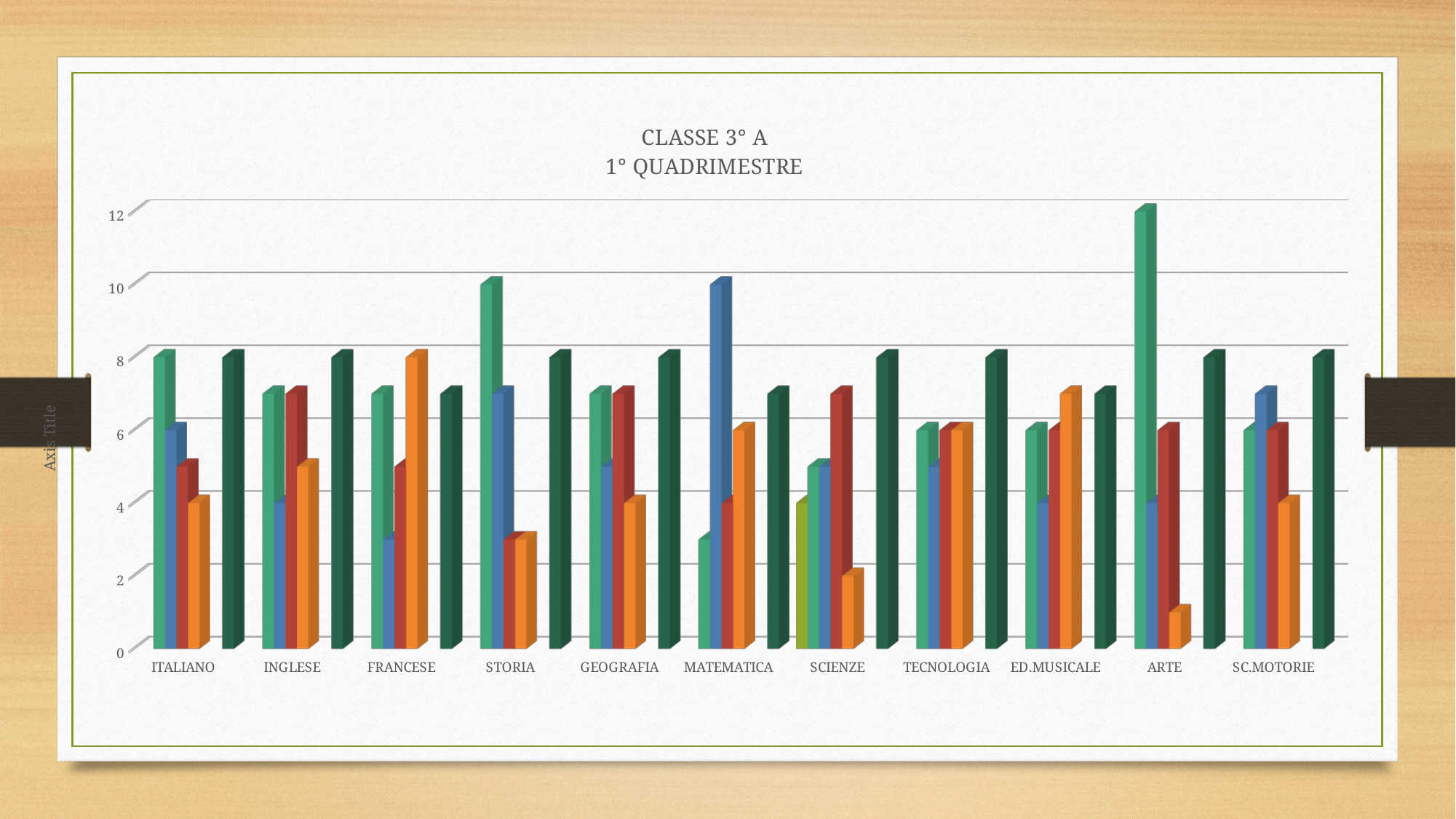
What kind of chart is shown on the slide? bar chart Which category contains the tallest bar in the chart? ARTE Is the orange bar for FRANCESE greater or less than 6? greater Is the tallest bar for ARTE greater or less than 10? greater For STORIA, which is taller: the first (green) bar or the orange bar? the green bar What text is shown as the vertical axis title? Axis Title Is the orange bar for SCIENZE greater or less than 4? less How many subject categories are shown along the x axis? 11 What is the title of the chart? CLASSE 3° A 1° QUADRIMESTRE What value does the tallest bar in the chart (in ARTE) reach on the axis? 12